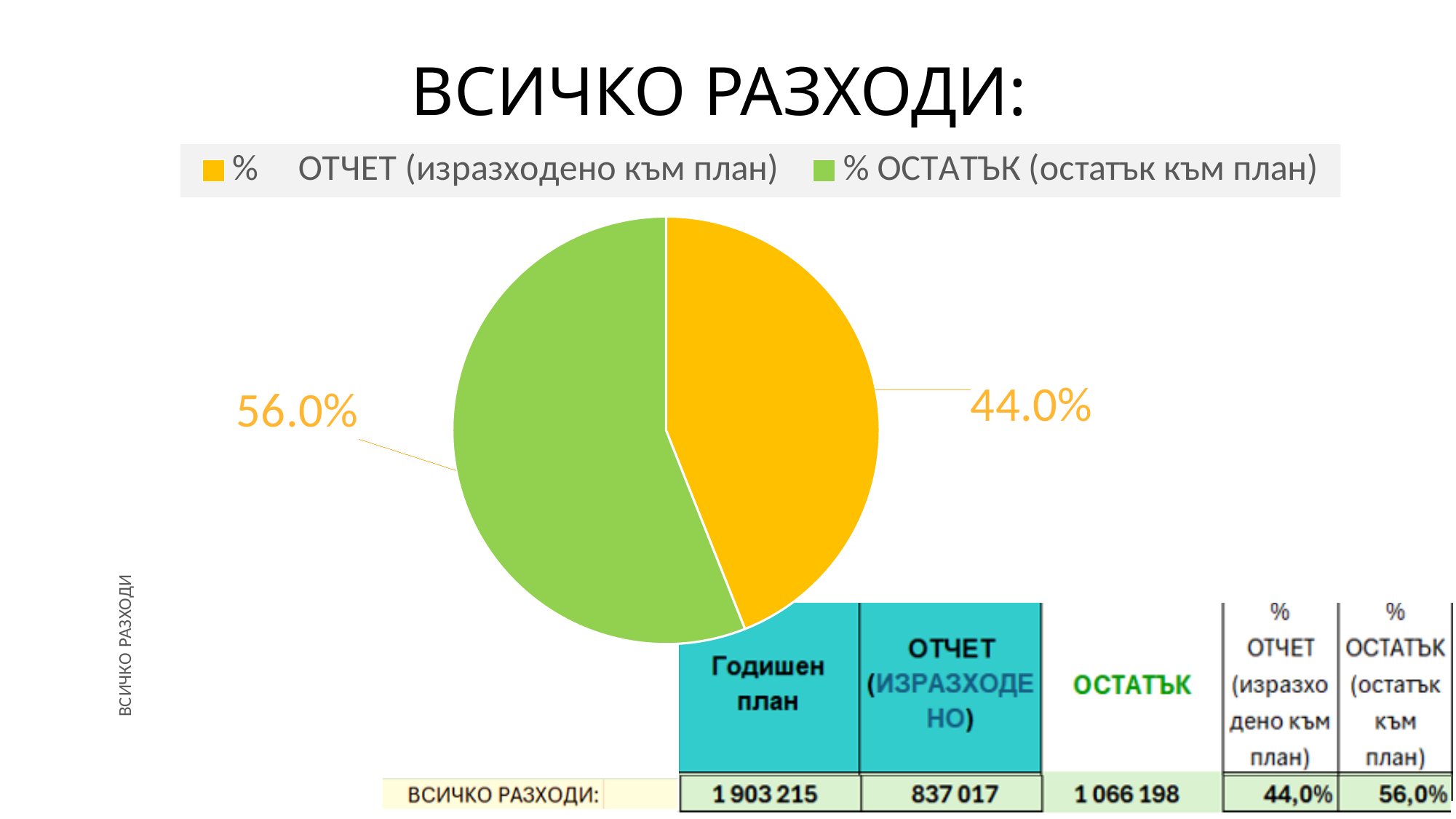
What colour is the % ОСТАТЪК (остатък към план) slice? green How many slices does the pie chart have? 2 Which slice of the pie is the smallest? % ОТЧЕТ (изразходено към план) What share of the pie is labelled for % ОСТАТЪК (остатък към план)? 56.0% What share of the pie is labelled for % ОТЧЕТ (изразходено към план)? 44.0% How many entries does the chart legend list? 2 Which slice of the pie is the largest? % ОСТАТЪК (остатък към план) What is the difference in percentage points between the % ОСТАТЪК slice and the % ОТЧЕТ slice? 12.0% Is the share for % ОТЧЕТ (изразходено към план) greater or less than 50%? less Which is larger: the % ОТЧЕТ slice or the % ОСТАТЪК slice? % ОСТАТЪК What kind of chart is shown on the slide? pie chart What is the title of the chart? ВСИЧКО РАЗХОДИ: